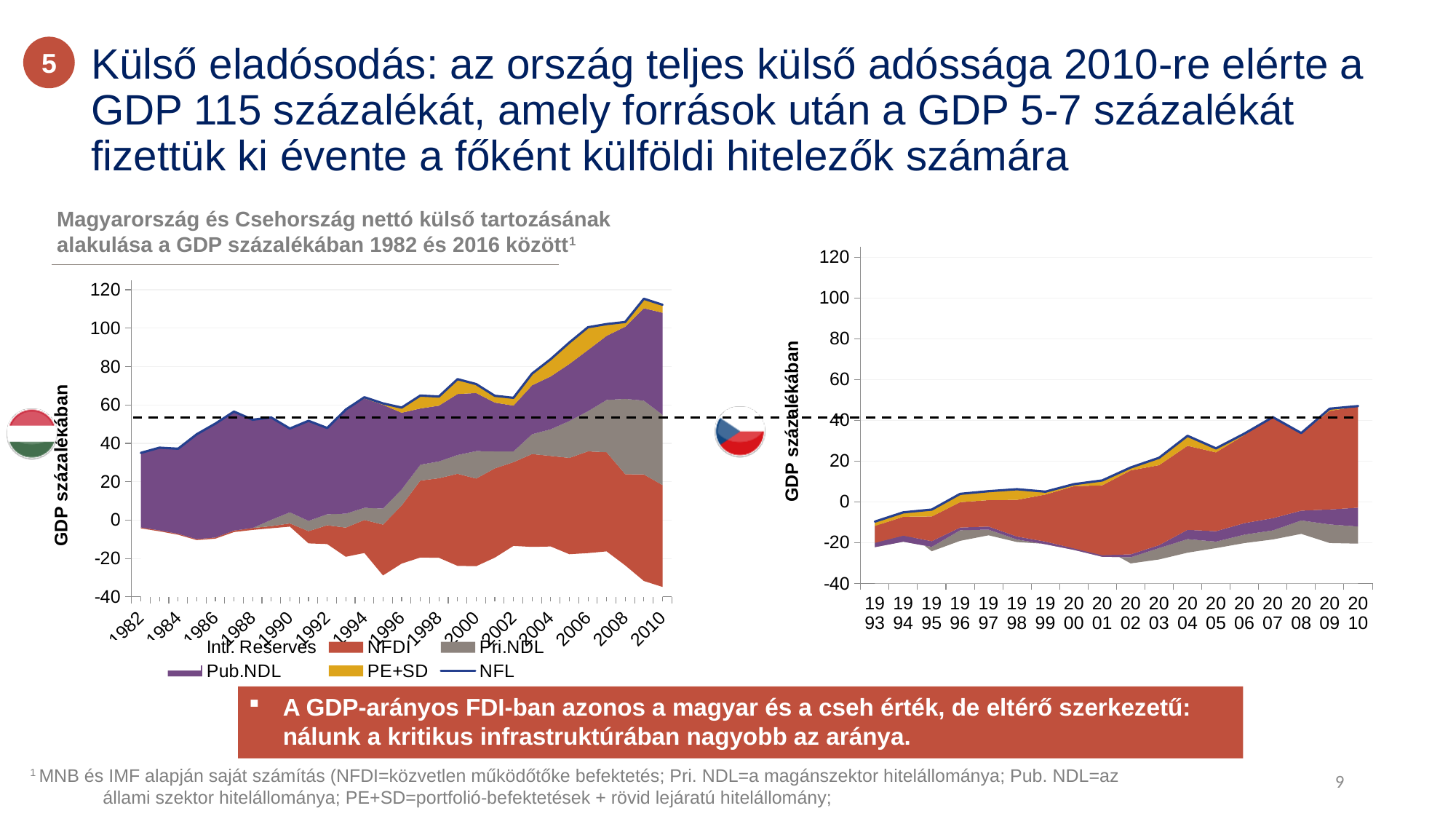
In the right chart (Czech Republic), is the NFL value for 1993 greater or less than 0? less How many series does the legend below the left chart list? 6 In the left chart (Hungary), is the NFL value for 2010 greater or less than 100? greater What is the y-axis label of the left chart? GDP százalékában In the right chart (Czech Republic), is the NFL value for 2010 greater or less than 40? greater In the left chart (Hungary), does the NFL line overall rise or fall from 1982 to 2010? rise How many years are labelled on the x axis of the right chart (Czech Republic)? 18 What kind of chart is the left chart (Hungary, 1982–2010)? stacked area chart In the left chart (Hungary), which year has the larger NFL value, 1982 or 2010? 2010 In the right chart (Czech Republic), does the NFL line overall rise or fall from 1993 to 2010? rise